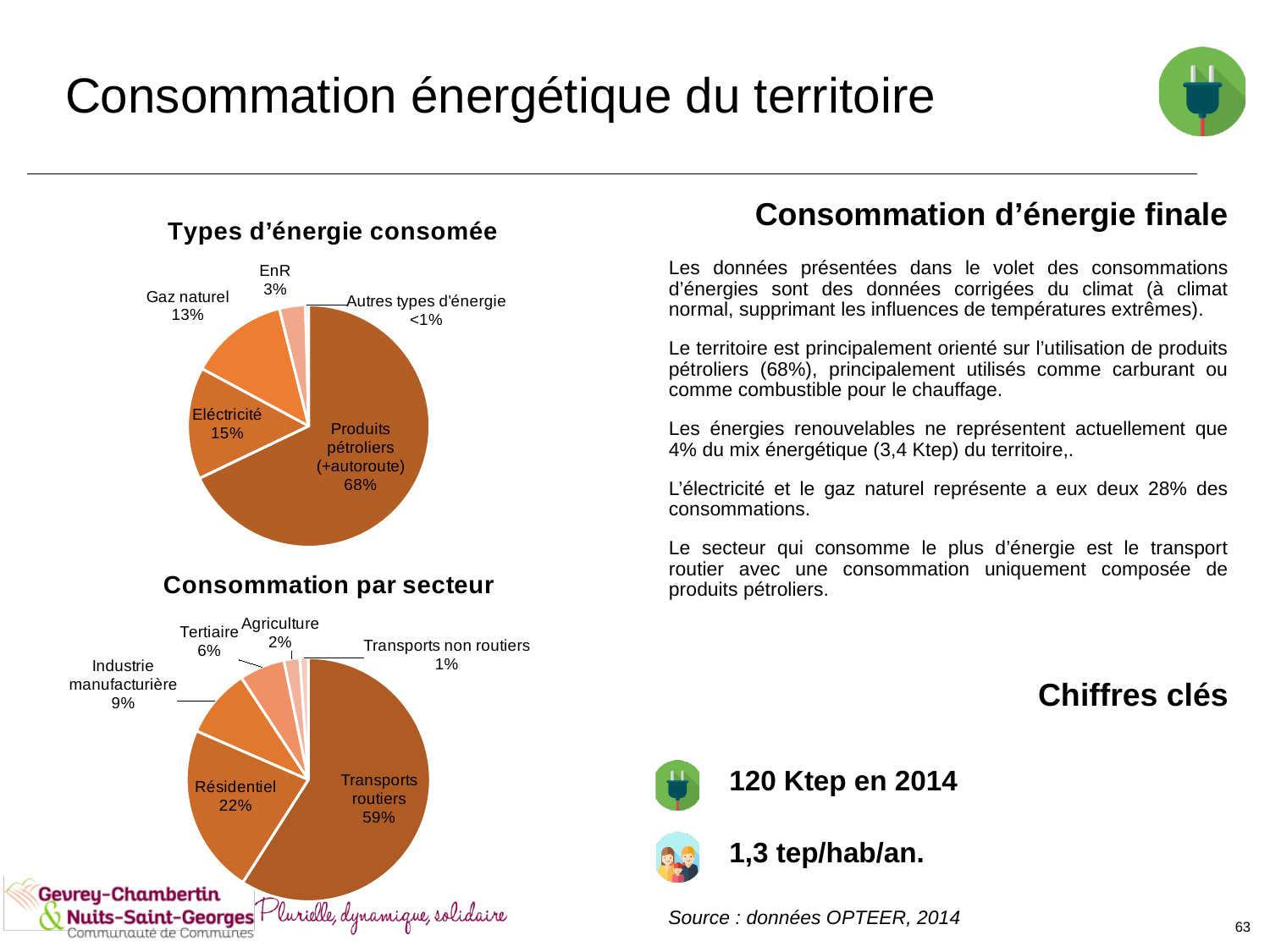
In the 'Consommation par secteur' chart, what share is shown for Industrie manufacturière? 9% What type of chart is used for 'Consommation par secteur'? Pie chart In the 'Types d'énergie consomée' chart, how many slices does the pie have? 5 In the 'Types d'énergie consomée' chart, which category has the smallest slice? Autres types d'énergie In the 'Types d'énergie consomée' chart, what share is shown for Gaz naturel? 13% In the 'Consommation par secteur' chart, what is the difference in percentage points between Transports routiers and Résidentiel? 37 In the 'Types d'énergie consomée' chart, what is the difference in percentage points between Eléctricité and EnR? 12 In the 'Consommation par secteur' chart, what share is shown for Transports routiers? 59% In the 'Types d'énergie consomée' chart, what share is shown for Produits pétroliers (+autoroute)? 68% In the 'Consommation par secteur' chart, how many sectors are shown? 6 In the 'Consommation par secteur' chart, which sector has the largest slice? Transports routiers In the 'Consommation par secteur' chart, which is larger, Résidentiel or Tertiaire? Résidentiel